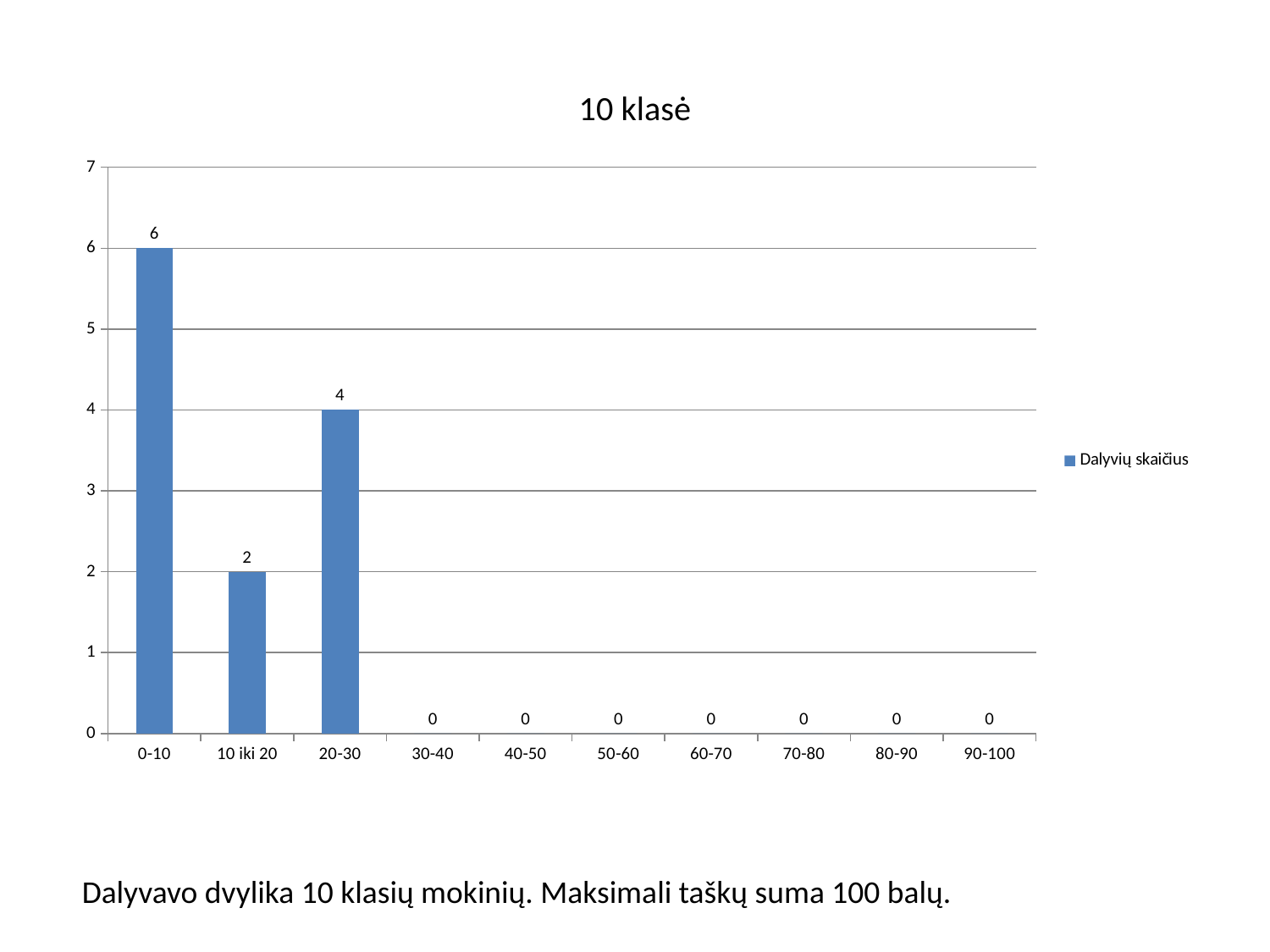
What is the value for the 50-60 category? 0 What is the title of the chart? 10 klasė What is the difference between the values for 0-10 and 20-30? 2 Which is larger, the value for 10 iki 20 or the value for 20-30? 20-30 What is the value for the 10 iki 20 category? 2 What is the value for the 0-10 category? 6 What is the value for the 20-30 category? 4 What is the difference between the values for 20-30 and 10 iki 20? 2 How many categories are shown on the x axis? 10 How many series does the legend list? 1 What kind of chart is shown on the slide? bar chart Which category has the highest value? 0-10